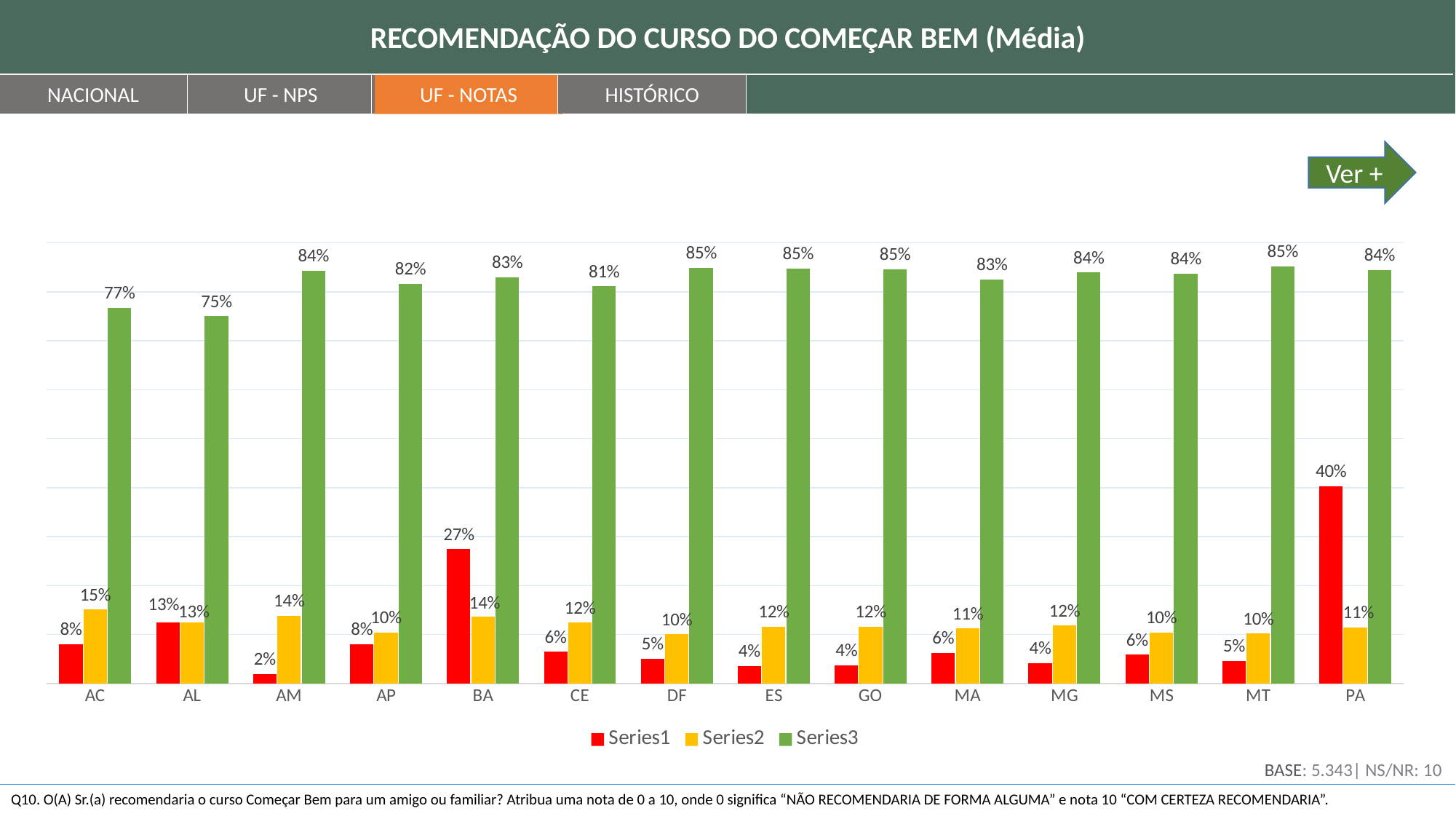
What is the value of Series2 for AC? 15% What is the value of Series3 for AC? 77% What kind of chart is shown on the slide? Bar chart Which category has the lowest Series3 value? AL How many categories are shown on the x axis? 14 Which is larger: the Series1 value for BA or the Series1 value for AL? BA What is the value of Series1 for PA? 40% Which category has the lowest Series1 value? AM What is the difference between the Series1 value for PA and the Series1 value for BA? 13% Which category has the highest Series1 value? PA How many series does the legend list? 3 What is the difference between the Series3 value for AM and the Series3 value for AC? 7%